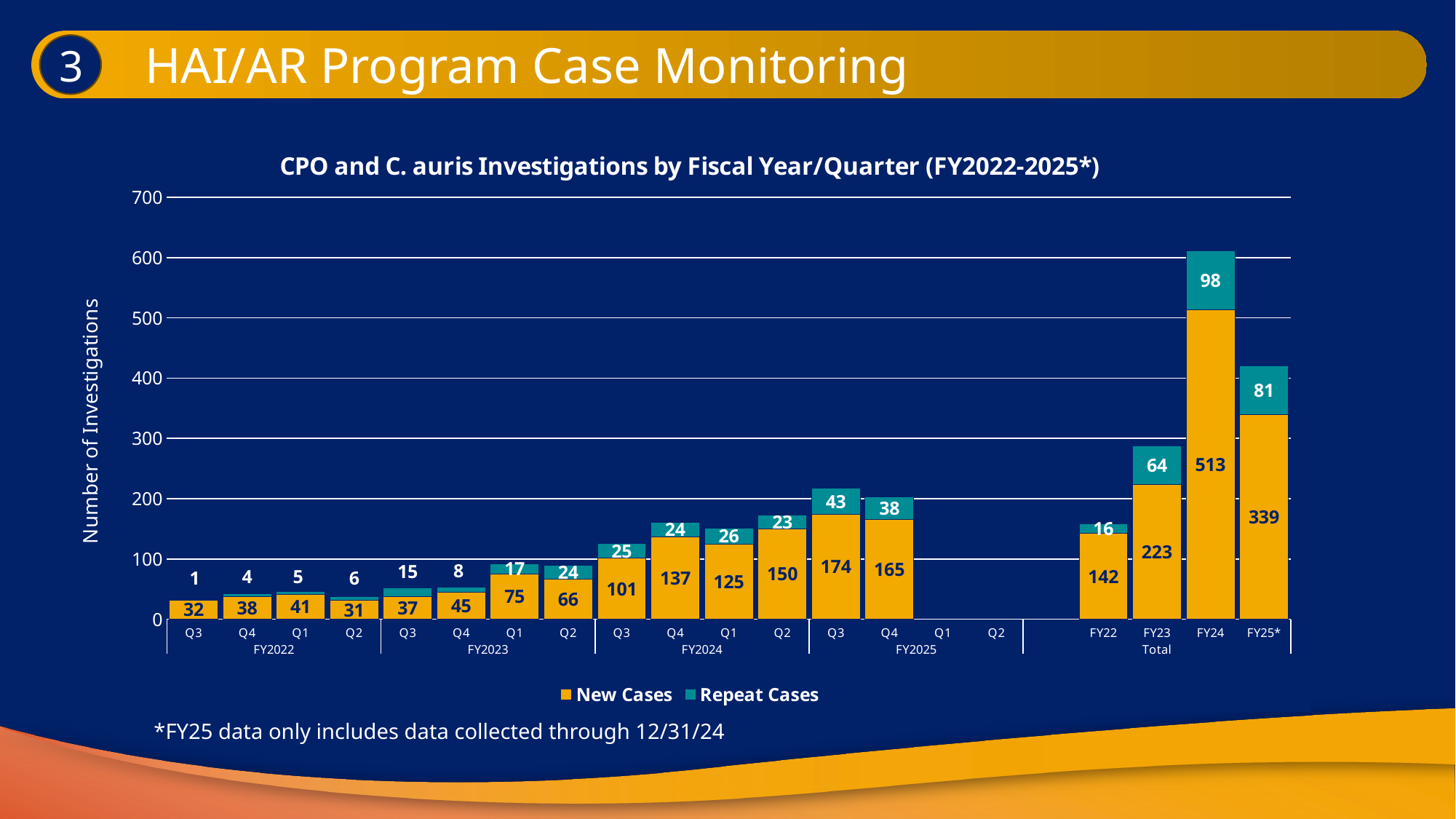
Which quarter has the lowest number of New Cases? Q2 FY2022 How many Repeat Cases are shown for Q3 of FY2025? 43 How many Repeat Cases are shown for Q2 of FY2023? 24 Among the fiscal year Total bars, which has the highest number of New Cases? FY24 What kind of chart is shown on the slide? Stacked bar chart Which has more New Cases: Q4 of FY2024 or Q1 of FY2024? Q4 of FY2024 Do New Cases in the Total group rise or fall from FY22 to FY24? Rise What is the total of New Cases and Repeat Cases for the FY25* Total bar? 420 How many series does the legend list? 2 What is the difference in New Cases between the FY24 Total and the FY23 Total? 290 What is the total height (New Cases plus Repeat Cases) of the FY24 Total bar? 611 What is the number of New Cases for the FY24 Total bar? 513